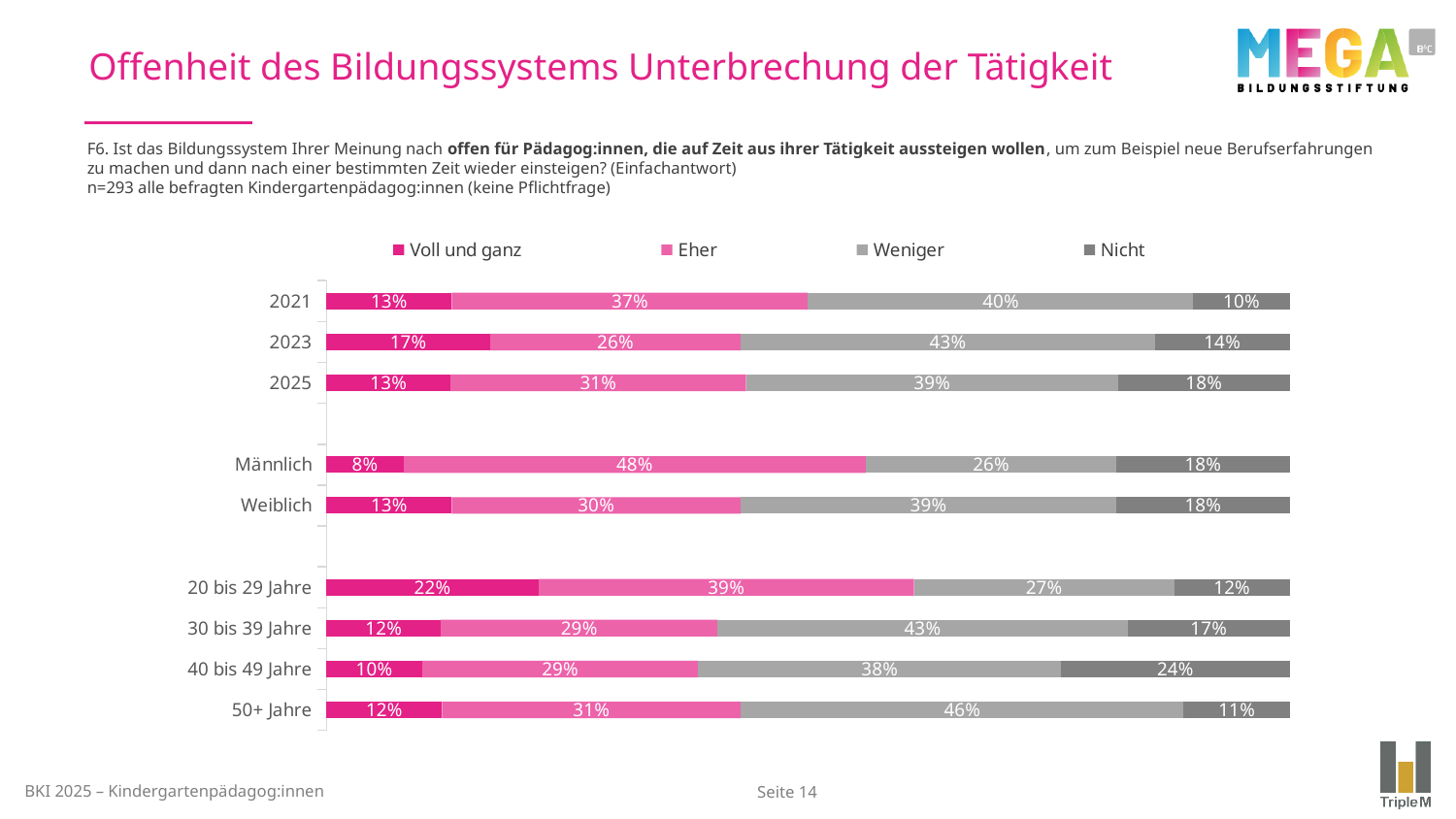
How many series does the legend list? 4 Which category has the lowest "Voll und ganz" value? Männlich What kind of chart is shown on the slide? Stacked bar chart How does the "Nicht" value change from 2021 to 2025? It rises What is the difference between the "Weniger" values for 50+ Jahre and 20 bis 29 Jahre? 19 percentage points What is the "Nicht" value for 40 bis 49 Jahre? 24% How many categories are plotted on the chart? 9 Which is larger: the "Nicht" value for 2021 or for 2025? 2025 Which category has the highest "Voll und ganz" value? 20 bis 29 Jahre Which series is shown in the darkest grey colour in the legend? Nicht What is the "Voll und ganz" value for 2023? 17% What is the "Eher" value for Männlich? 48%